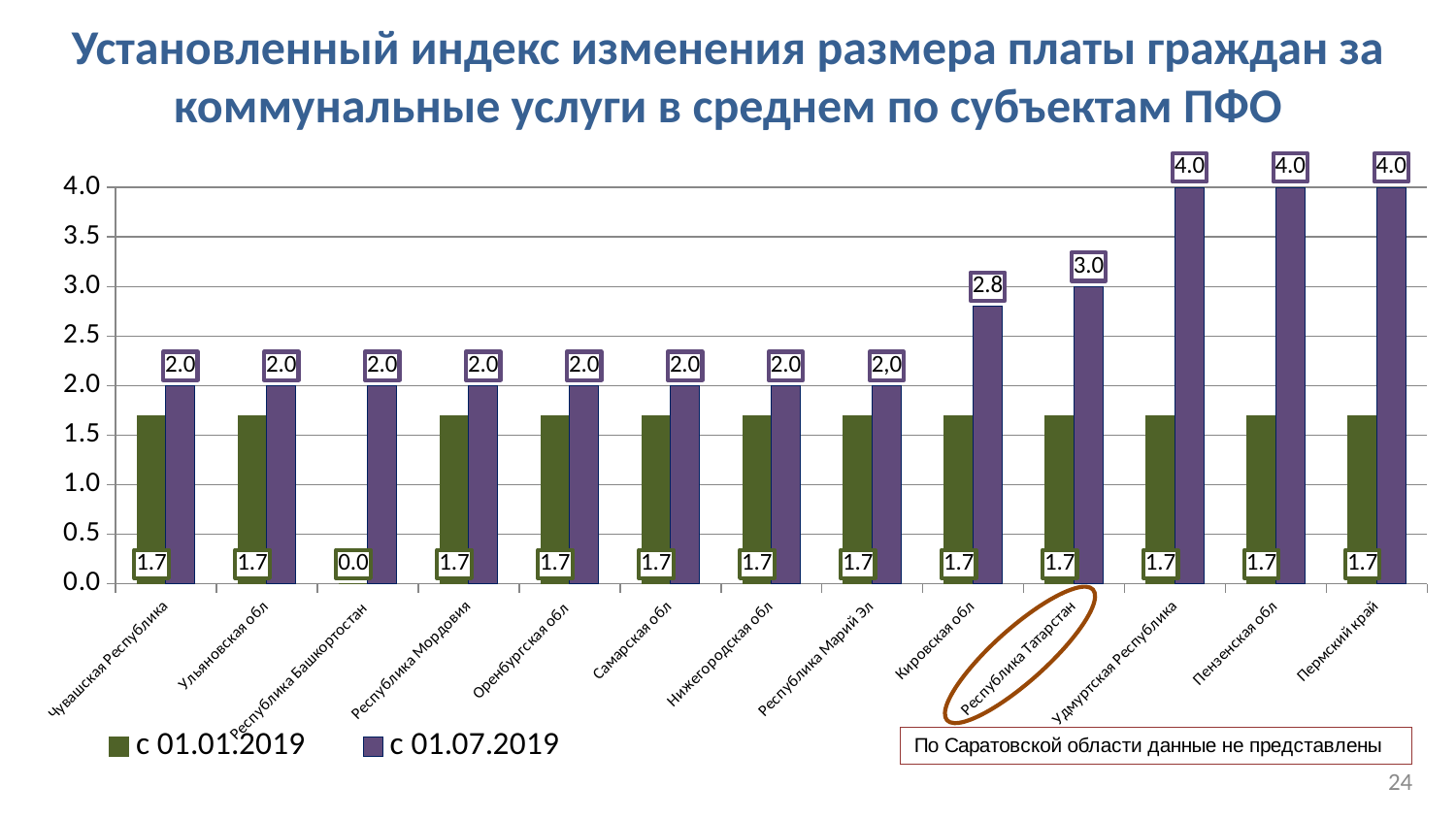
What is the value for Пермский край in the series с 01.07.2019? 4.0 What is the value for Кировская обл in the series с 01.07.2019? 2.8 Which category has the lowest value in the series с 01.01.2019? Республика Башкортостан In the series с 01.07.2019, what is the difference between Республика Татарстан and Кировская обл? 0.2 For Удмуртская Республика, what is the difference between the с 01.07.2019 value and the с 01.01.2019 value? 2.3 What is the value for Республика Башкортостан in the series с 01.01.2019? 0.0 In the series с 01.07.2019, which is larger: Кировская обл or Республика Татарстан? Республика Татарстан How many series does the legend list? 2 What is the value for Республика Татарстан in the series с 01.07.2019? 3.0 What kind of chart is shown on the slide? bar chart For Республика Татарстан, what is the difference between the с 01.07.2019 value and the с 01.01.2019 value? 1.3 How many categories (regions) are shown on the x axis? 13